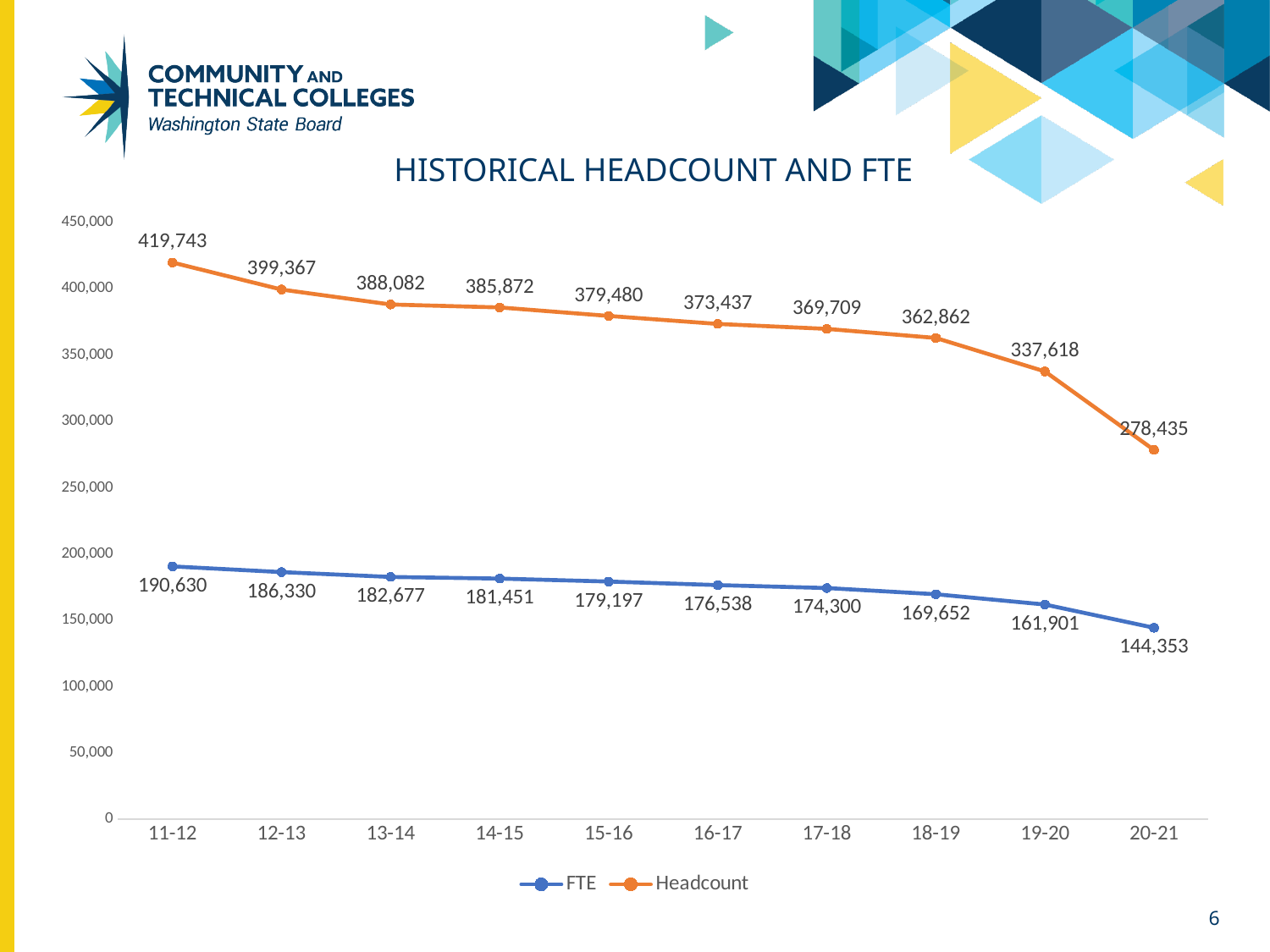
How many years are shown on the x axis? 10 What is the difference between the Headcount for 19-20 and the Headcount for 20-21? 59,183 What kind of chart is shown on the slide? Line chart How many series does the legend list? 2 What is the FTE value for 20-21? 144,353 Do the Headcount values rise or fall from 11-12 to 20-21? Fall What is the FTE value for 15-16? 179,197 Which year has the lowest FTE? 20-21 What is the Headcount value for 11-12? 419,743 Which year has the highest Headcount? 11-12 What is the Headcount value for 19-20? 337,618 Which is larger, the FTE for 12-13 or the FTE for 18-19? FTE for 12-13